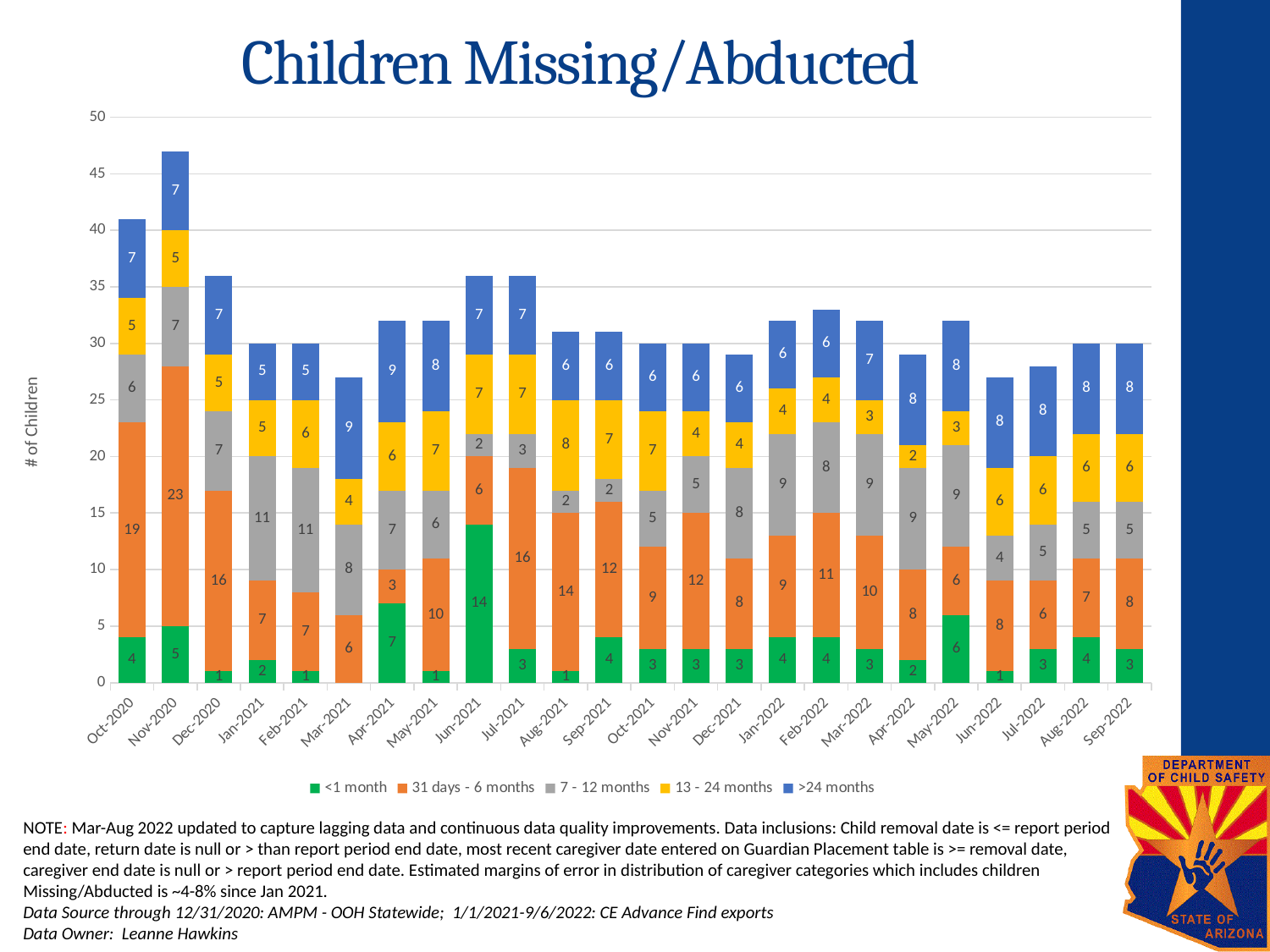
How many series does the legend list? 5 What is the total number of children in Sep-2022? 30 What type of chart is shown on the slide? stacked bar chart Is the total for Nov-2020 greater or less than 45? greater What is the value for '31 days - 6 months' in Nov-2020? 23 What is the total number of children in Oct-2020? 41 What is the difference between the '31 days - 6 months' values for Nov-2020 and Dec-2020? 7 How many months are shown along the x axis? 24 What is the value for '>24 months' in Mar-2021? 9 Which month has the highest total number of children? Nov-2020 Which is larger, the '7 - 12 months' value in Jan-2021 or in Jun-2021? Jan-2021 What is the value for '<1 month' in Jun-2021? 14